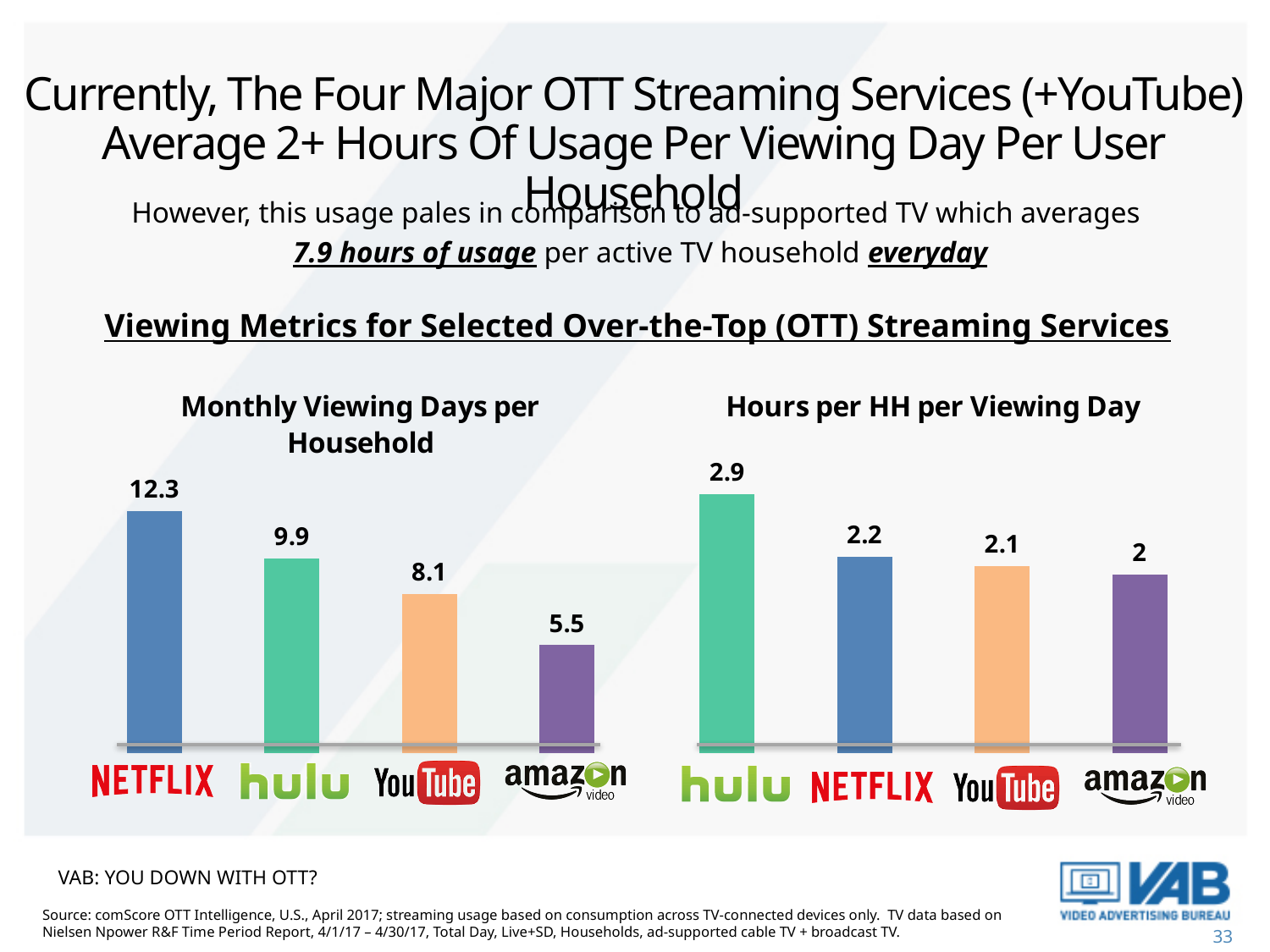
In the 'Monthly Viewing Days per Household' chart, what is the value for Amazon Video? 5.5 How many services are shown in the 'Hours per HH per Viewing Day' chart? 4 In the 'Monthly Viewing Days per Household' chart, what is the value for Netflix? 12.3 In the 'Monthly Viewing Days per Household' chart, do the values rise or fall from left to right? Fall In the 'Monthly Viewing Days per Household' chart, which is larger, the value for YouTube or the value for Amazon Video? YouTube In the 'Hours per HH per Viewing Day' chart, what is the value for Hulu? 2.9 In the 'Hours per HH per Viewing Day' chart, what is the value for YouTube? 2.1 In the 'Hours per HH per Viewing Day' chart, what is the difference between Hulu and Netflix? 0.7 What kind of chart is the 'Monthly Viewing Days per Household' chart? Bar chart In the 'Monthly Viewing Days per Household' chart, what is the difference between Netflix and Hulu? 2.4 In the 'Hours per HH per Viewing Day' chart, which service has the lowest value? Amazon Video In the 'Monthly Viewing Days per Household' chart, which service has the highest value? Netflix